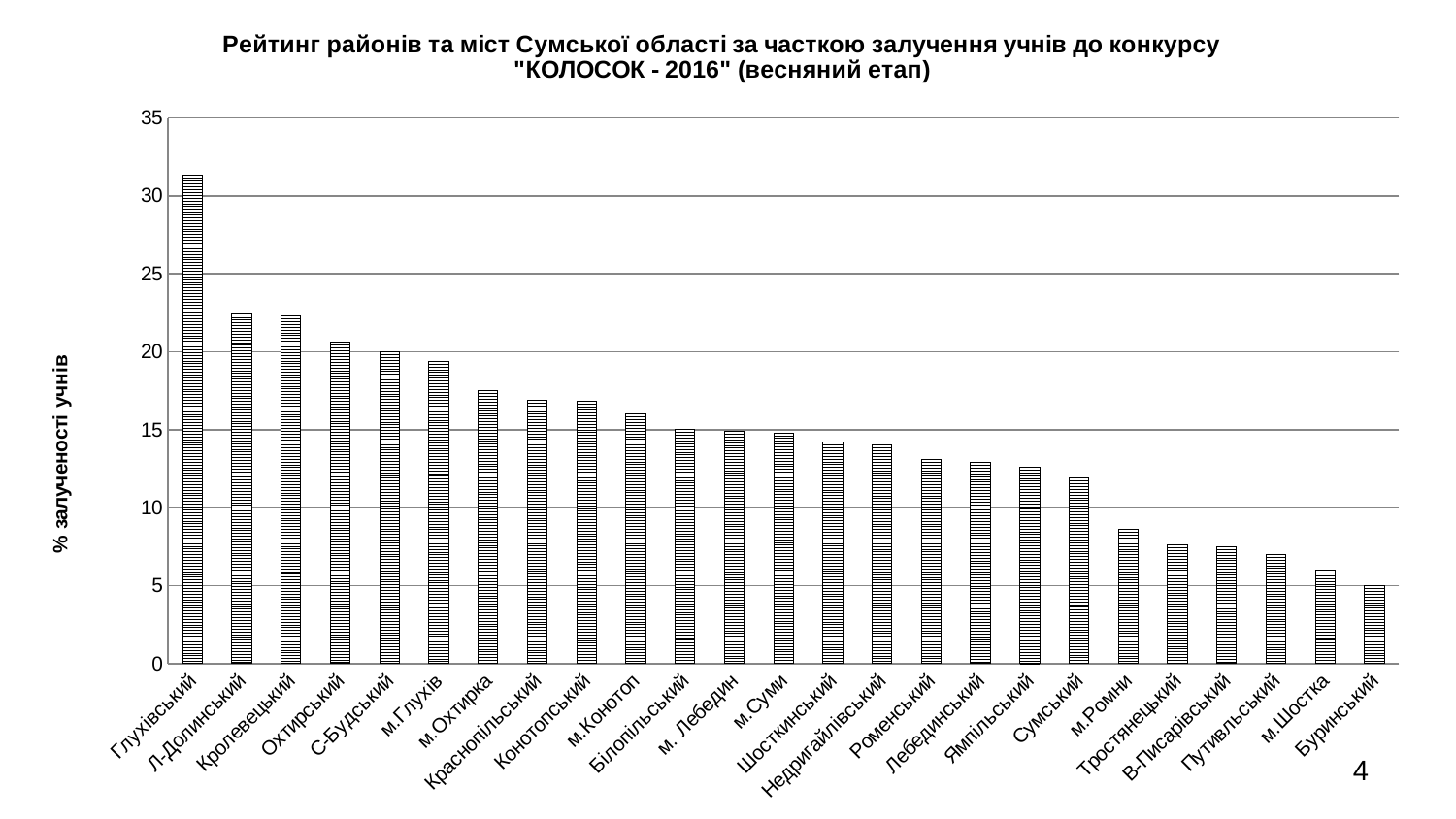
Is the value for Глухівський greater or less than 30? greater What kind of chart is shown on the slide? Bar chart Which district or city has the lowest share of pupils involved in the contest? Буринський Is the value for м.Ромни greater or less than 10? less Which district or city has the highest share of pupils involved in the contest? Глухівський Which is larger, the value for Глухівський or the value for Буринський? Глухівський Do the values rise or fall moving from left to right along the x axis? Fall What is the label of the vertical axis? % залученості учнів Is the value for Сумський greater or less than 10? greater How many districts and cities are shown on the x axis? 25